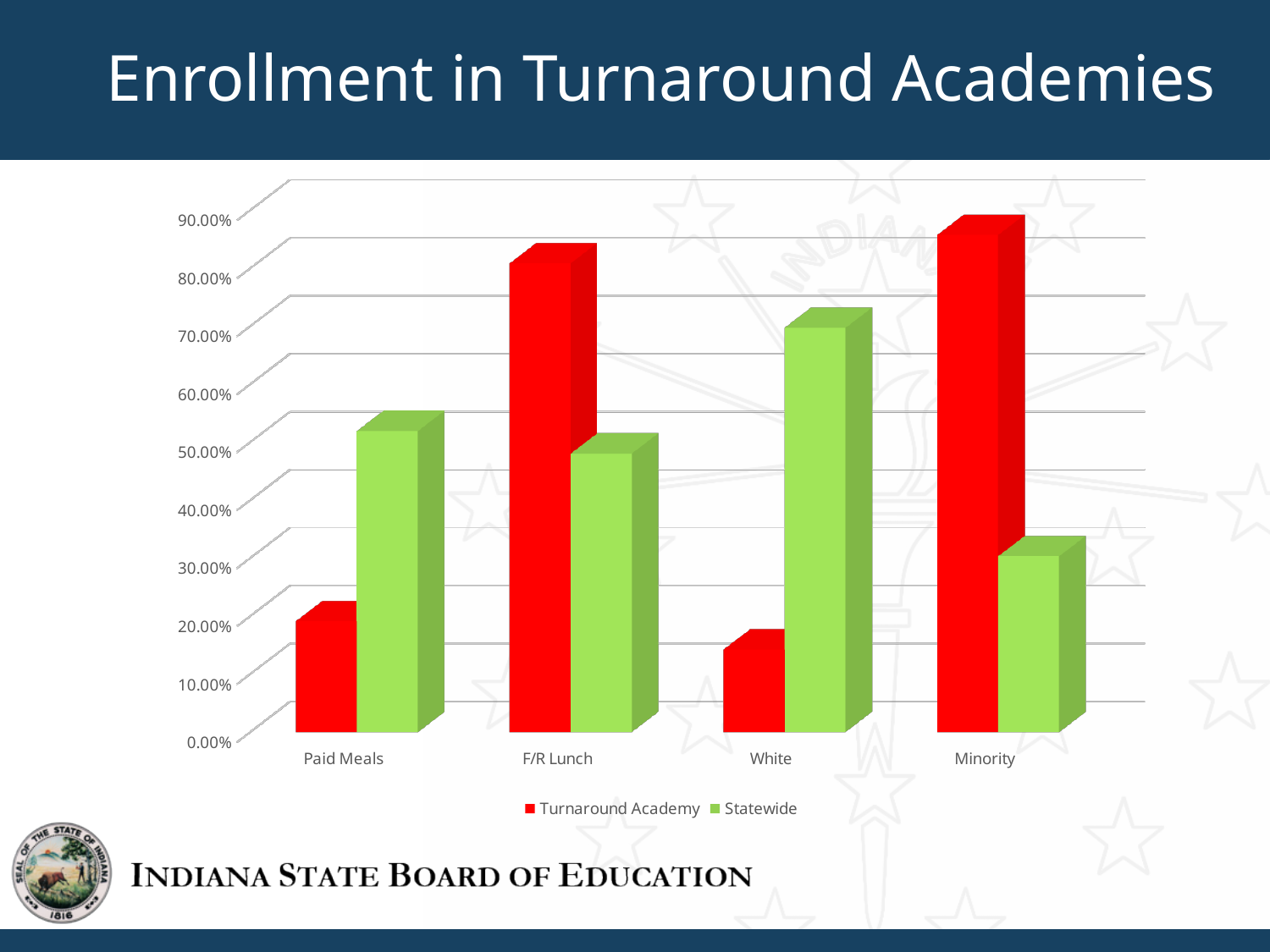
For Minority, which is larger: Turnaround Academy or Statewide? Turnaround Academy Which series is shown in red in the chart? Turnaround Academy Which category has the lowest Statewide value? Minority For Paid Meals, which is larger: Turnaround Academy or Statewide? Statewide How many categories are shown on the x axis of the chart? 4 How many series does the chart's legend list? 2 What is the title of the slide containing the chart? Enrollment in Turnaround Academies Is the Statewide value for White greater or less than 60.00%? greater For F/R Lunch, which is larger: Turnaround Academy or Statewide? Turnaround Academy Which category has the highest Statewide value? White What kind of chart is shown on the slide? bar chart Is the Turnaround Academy value for Paid Meals greater or less than 30.00%? less